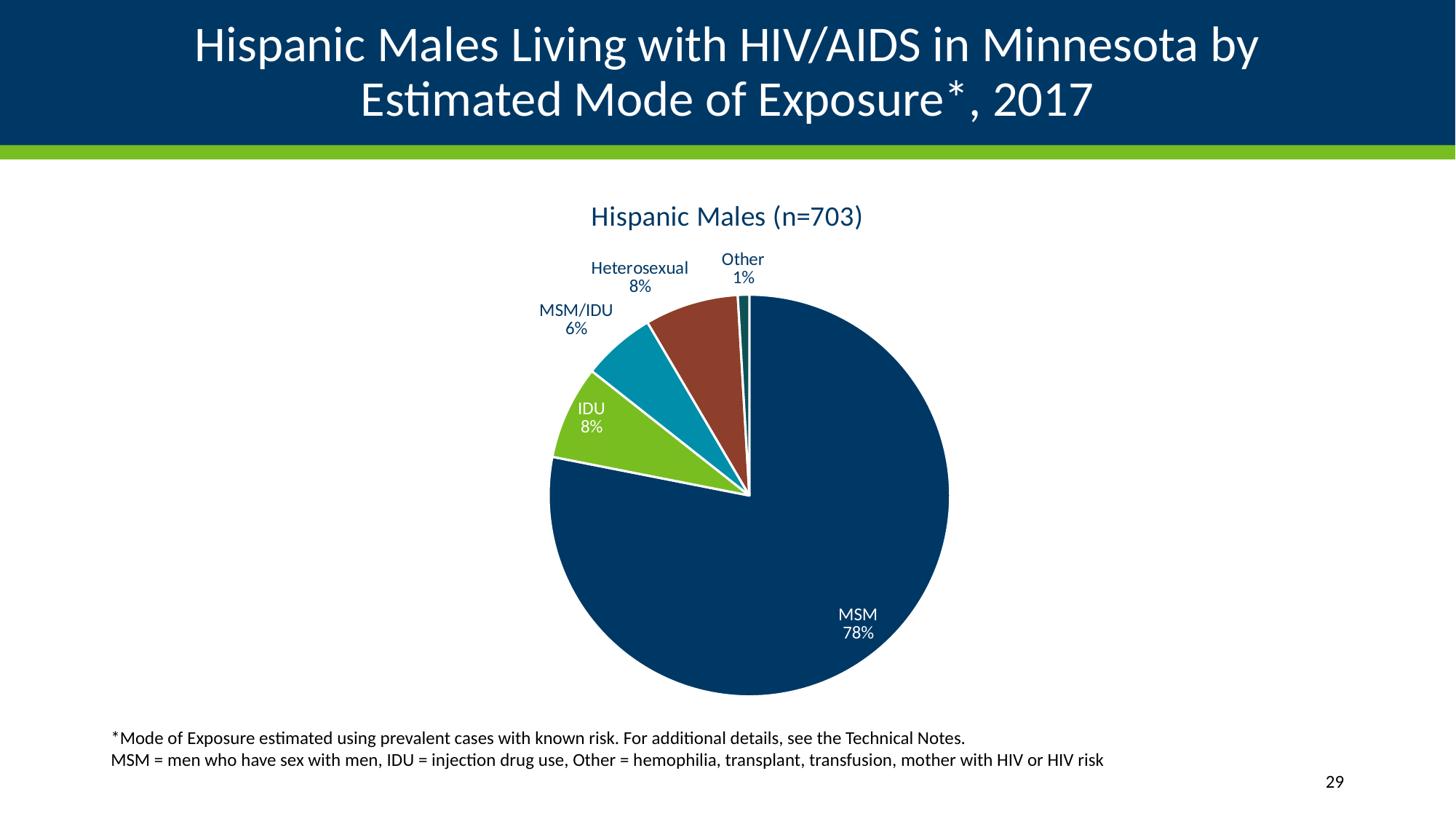
Which mode of exposure has the largest share of the pie? MSM How many slices does the pie chart have? 5 What percentage is attributed to MSM/IDU? 6% What percentage of Hispanic males living with HIV/AIDS is attributed to MSM? 78% What is the total number of Hispanic males (n) shown in the chart title? 703 Which is larger, the share for MSM/IDU or the share for IDU? IDU Which mode of exposure has the smallest share of the pie? Other What is the difference in percentage points between MSM and Heterosexual? 70 What percentage is attributed to Heterosexual exposure? 8% What type of chart is shown on the slide? Pie chart What percentage is attributed to Other? 1% What percentage is attributed to IDU? 8%